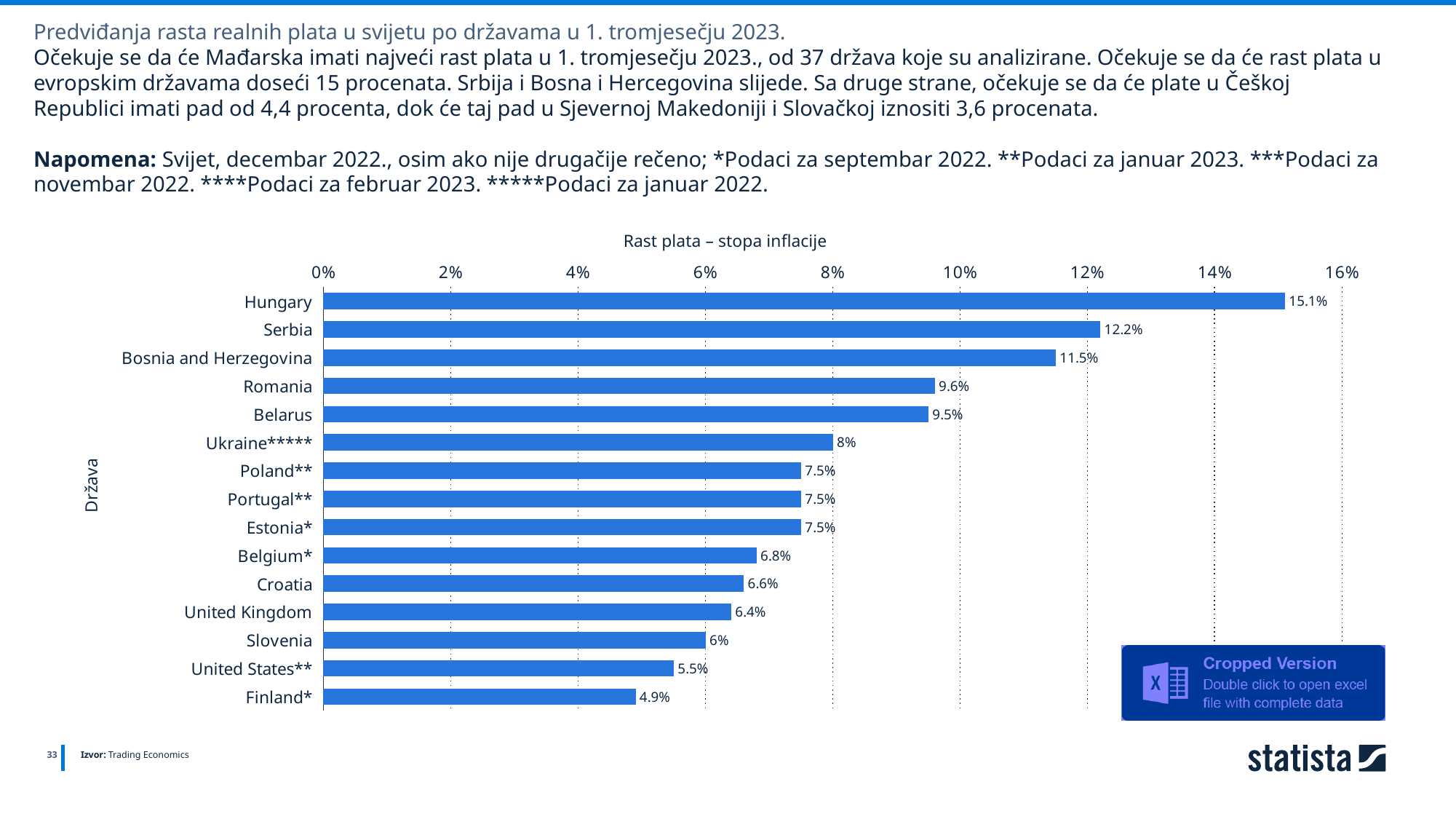
What is the difference between the values for Serbia and Romania? 2.6% Which country has the highest value? Hungary What is the value for Hungary? 15.1% How many countries are shown in the chart? 15 What is the title of the chart? Rast plata – stopa inflacije What is the value for United Kingdom? 6.4% Which country has the lowest value? Finland* What is the label of the vertical axis? Država What kind of chart is shown on the slide? bar chart Which has a larger value, Belarus or Croatia? Belarus Is the value for Slovenia greater or less than 8%? less What is the value for Bosnia and Herzegovina? 11.5%